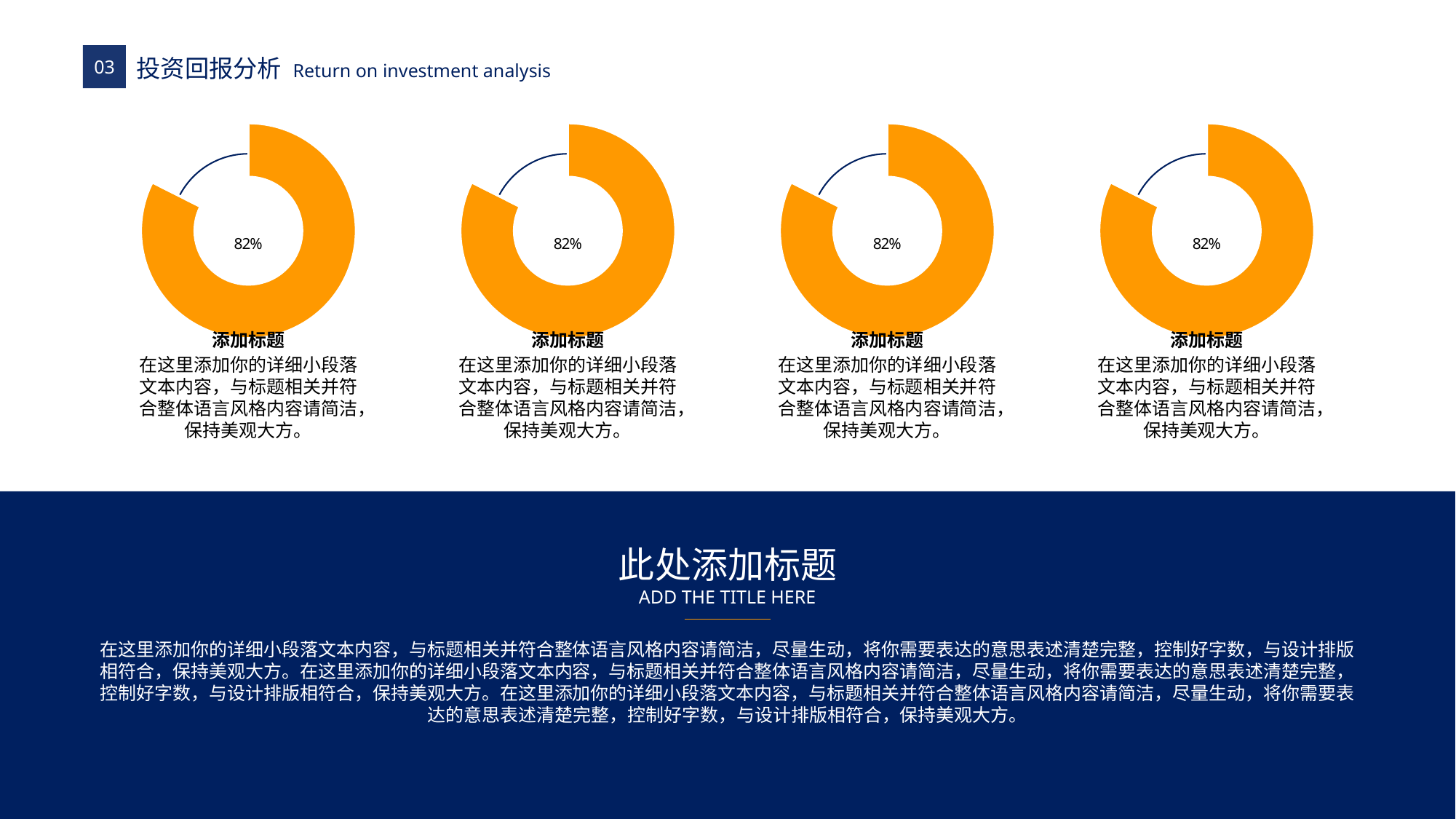
In the third donut chart from the left, what value is shown? 82% In the leftmost donut chart, what percentage is printed in the centre? 82% What is the difference between the value in the first donut chart and the value in the second donut chart? 0% In the second donut chart from the left, what value is shown? 82% What is the section title printed at the top of the slide above the charts? 投资回报分析 Return on investment analysis What kind of chart is shown in the leftmost chart on the slide? Donut (pie) chart What share of the rightmost donut chart does the orange slice represent? 82% How many donut charts are shown on the slide? 4 In the rightmost donut chart, what value is shown? 82% Is the value in the leftmost donut chart larger than, smaller than, or equal to the value in the rightmost donut chart? Equal What colour is the large slice in each donut chart? Orange